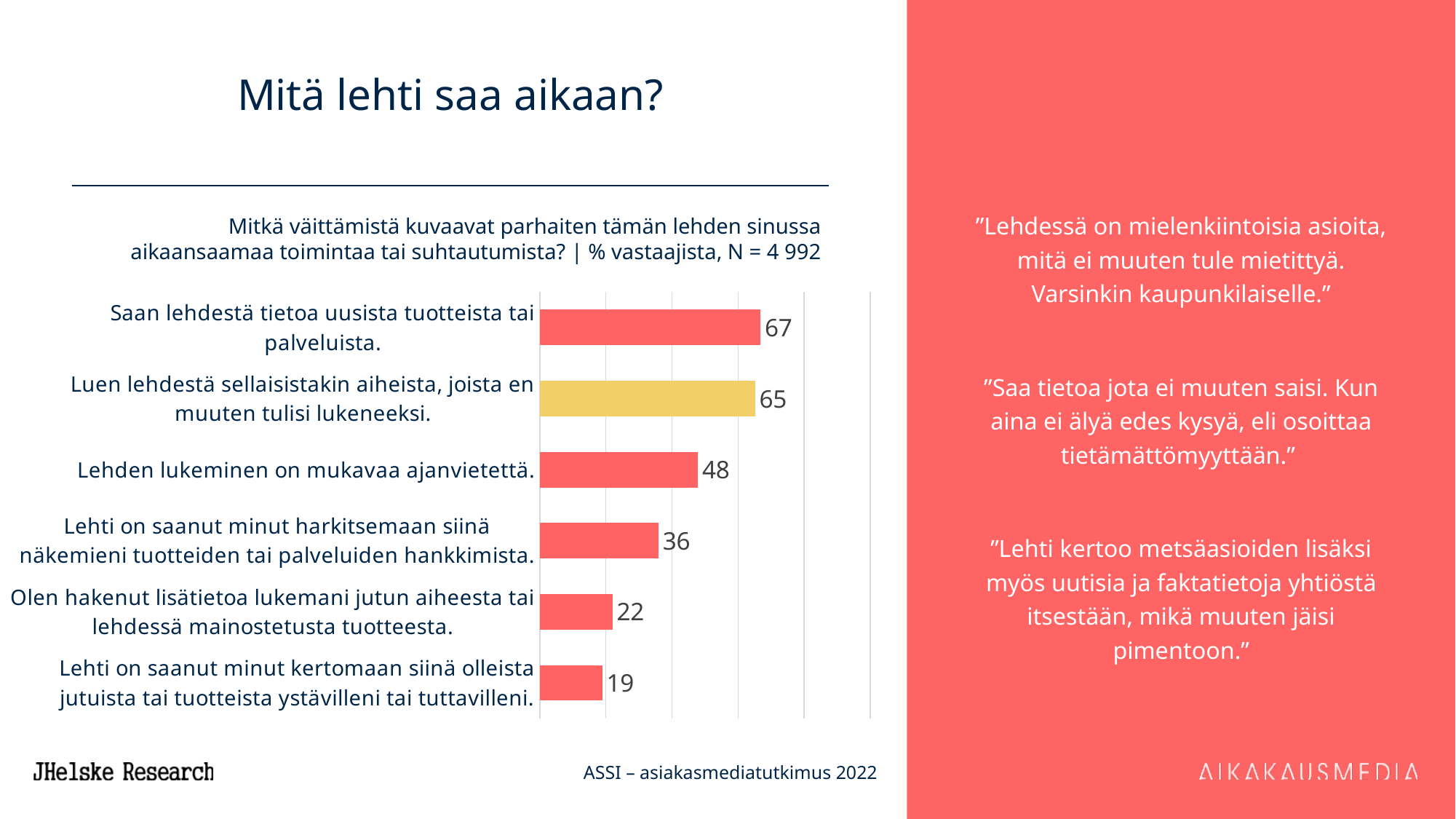
What is the value for "Lehti on saanut minut kertomaan siinä olleista jutuista tai tuotteista ystävilleni tai tuttavilleni."? 19 What is the difference between the values for "Lehden lukeminen on mukavaa ajanvietettä." and "Lehti on saanut minut harkitsemaan siinä näkemieni tuotteiden tai palveluiden hankkimista."? 12 Which category's bar is coloured yellow instead of red? Luen lehdestä sellaisistakin aiheista, joista en muuten tulisi lukeneeksi. What is the value for "Saan lehdestä tietoa uusista tuotteista tai palveluista."? 67 How many categories are shown in the chart? 6 What kind of chart is shown on the slide? Bar chart What is the value for "Olen hakenut lisätietoa lukemani jutun aiheesta tai lehdessä mainostetusta tuotteesta."? 22 Which is larger: the value for "Luen lehdestä sellaisistakin aiheista, joista en muuten tulisi lukeneeksi." or the value for "Lehden lukeminen on mukavaa ajanvietettä."? Luen lehdestä sellaisistakin aiheista, joista en muuten tulisi lukeneeksi. Which category has the highest value? Saan lehdestä tietoa uusista tuotteista tai palveluista. What is the value for "Lehden lukeminen on mukavaa ajanvietettä."? 48 What is the N (number of respondents) stated in the chart subtitle? 4 992 Which category has the lowest value? Lehti on saanut minut kertomaan siinä olleista jutuista tai tuotteista ystävilleni tai tuttavilleni.